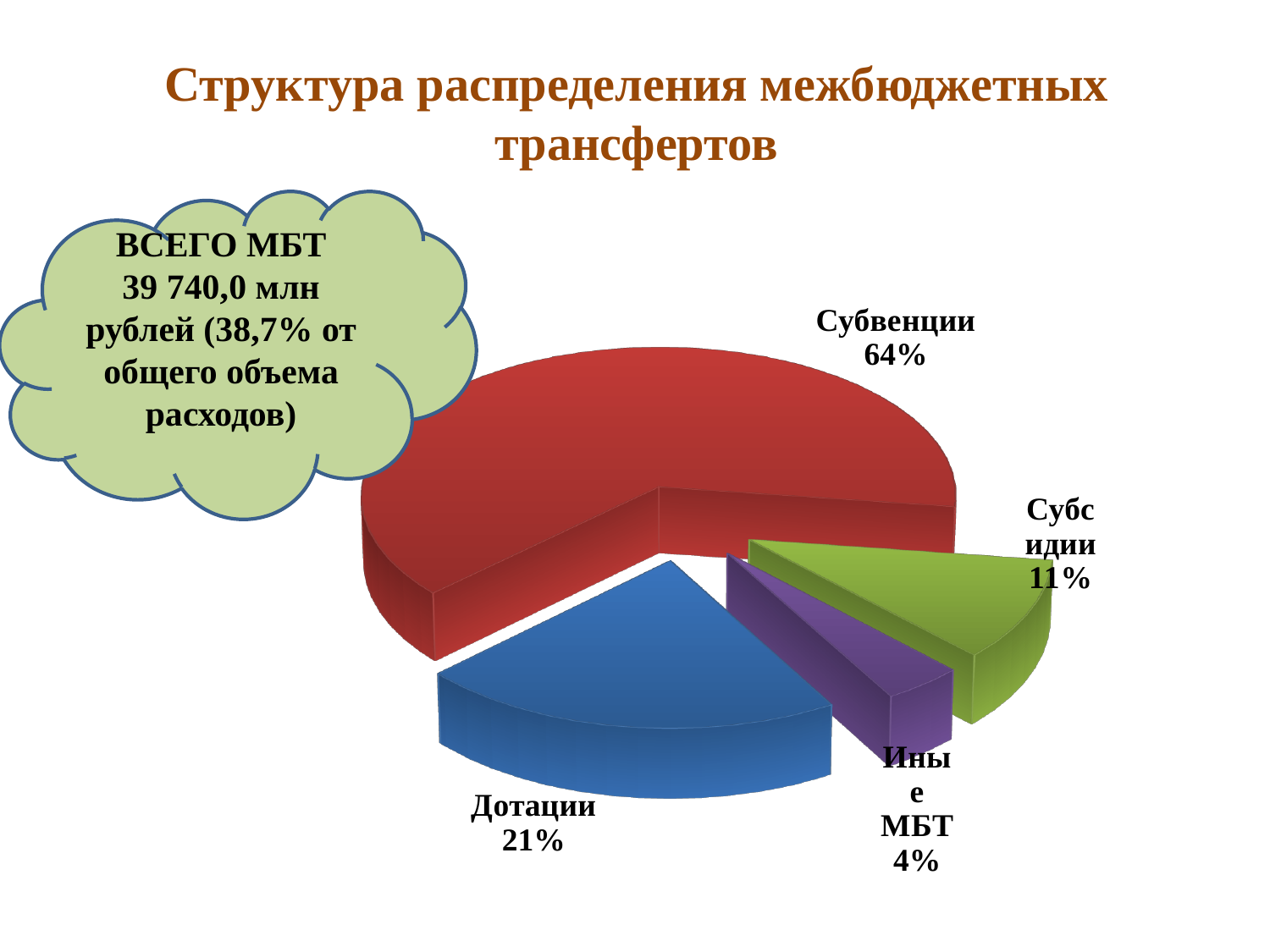
What share of the pie does Иные МБТ have? 4% What share of the pie does Субсидии have? 11% Which category has the largest share of the pie? Субвенции What type of chart is shown on the slide? Pie chart How many slices does the pie chart have? 4 Which category has the smallest share of the pie? Иные МБТ What is the title of the slide containing the pie chart? Структура распределения межбюджетных трансфертов What share of the pie does Субвенции have? 64% Which is larger, the share for Дотации or the share for Субсидии? Дотации What is the difference in percentage points between Субвенции and Дотации? 43 What colour is the Субвенции slice of the pie chart? Red